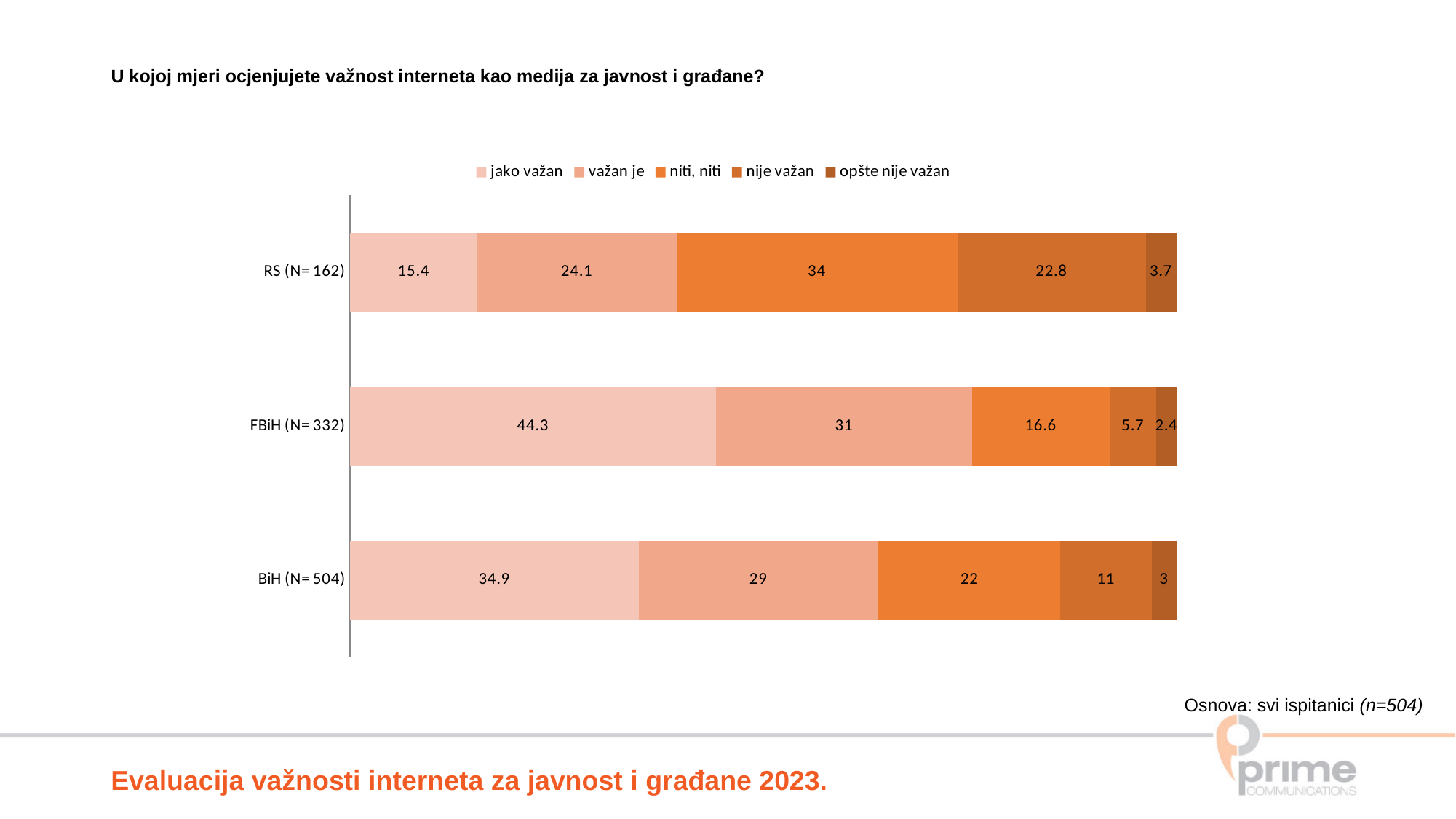
Which category has the highest value for "jako važan"? FBiH (N= 332) What is the total of the stacked bar for RS (N= 162)? 100 Which is larger: the "važan je" value for FBiH (N= 332) or for BiH (N= 504)? FBiH (N= 332) What is the difference between the "jako važan" values for FBiH (N= 332) and RS (N= 162)? 28.9 What is the value of "jako važan" for FBiH (N= 332)? 44.3 What is the value of "niti, niti" for RS (N= 162)? 34 What is the value of "nije važan" for BiH (N= 504)? 11 How many categories are shown on the chart? 3 Which category has the lowest value for "nije važan"? FBiH (N= 332) What kind of chart is shown on the slide? Stacked bar chart How many series does the legend list? 5 What is the value of "opšte nije važan" for FBiH (N= 332)? 2.4